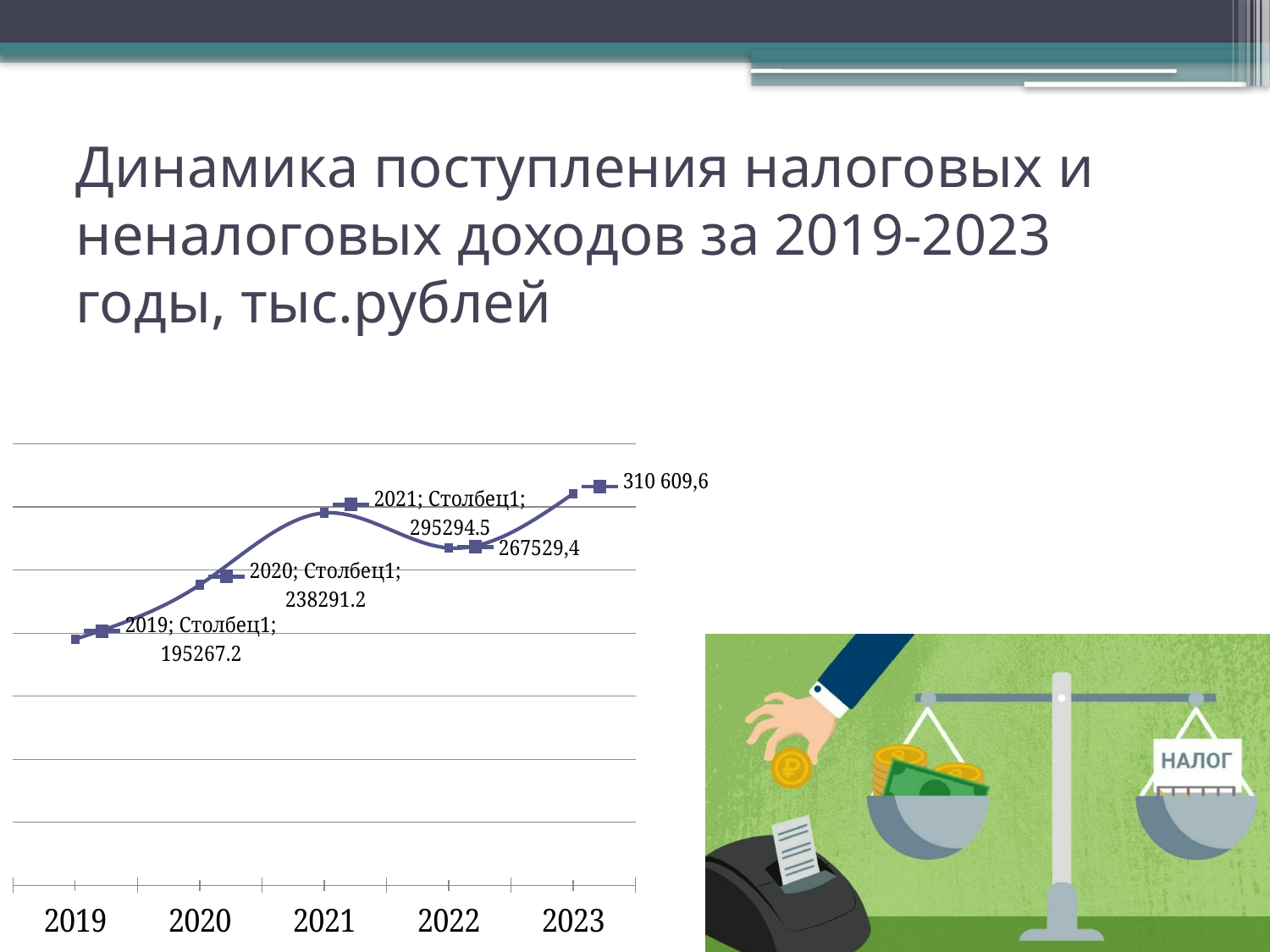
What is the value for 2019? 195267.2 What is the value for 2022? 267529,4 What is the difference between the values for 2020 and 2019? 43024 Which year has the lowest value? 2019 Which year has the highest value? 2023 Does the value rise or fall from 2021 to 2022? fall What is the value for 2021? 295294.5 What kind of chart is shown on the slide? line chart How many years are plotted on the x axis? 5 Is the value for 2021 larger or smaller than the value for 2022? larger What is the value for 2023? 310 609,6 What is the value for 2020? 238291.2